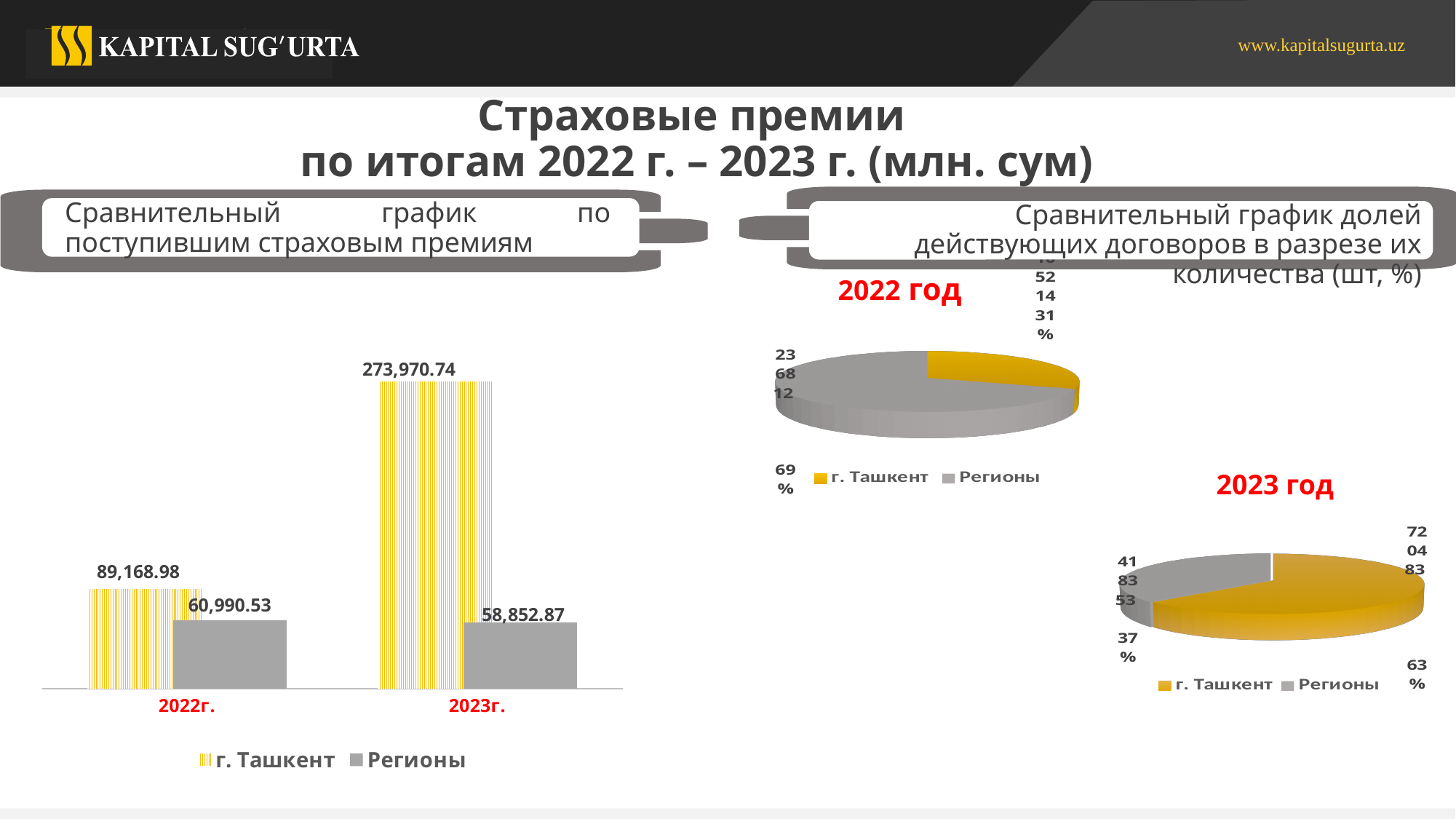
On the bar chart on the left, what is the value for Регионы in 2022г.? 60,990.53 What kind of chart is the chart on the left of the slide? bar chart On the 2023 год pie chart, which slice is larger, г. Ташкент or Регионы? г. Ташкент On the bar chart on the left, which bar has the highest value? г. Ташкент in 2023г. On the bar chart on the left, what is the difference between г. Ташкент and Регионы in 2023г.? 215,117.87 On the bar chart on the left, what is the difference between г. Ташкент and Регионы in 2022г.? 28,178.45 On the bar chart on the left, what is the value for г. Ташкент in 2022г.? 89,168.98 On the bar chart on the left, did the value for Регионы rise or fall from 2022г. to 2023г.? fall On the bar chart on the left, what is the value for Регионы in 2023г.? 58,852.87 On the bar chart on the left, which bar has the lowest value? Регионы in 2023г. On the bar chart on the left, how many series does the legend list? 2 On the bar chart on the left, what is the value for г. Ташкент in 2023г.? 273,970.74